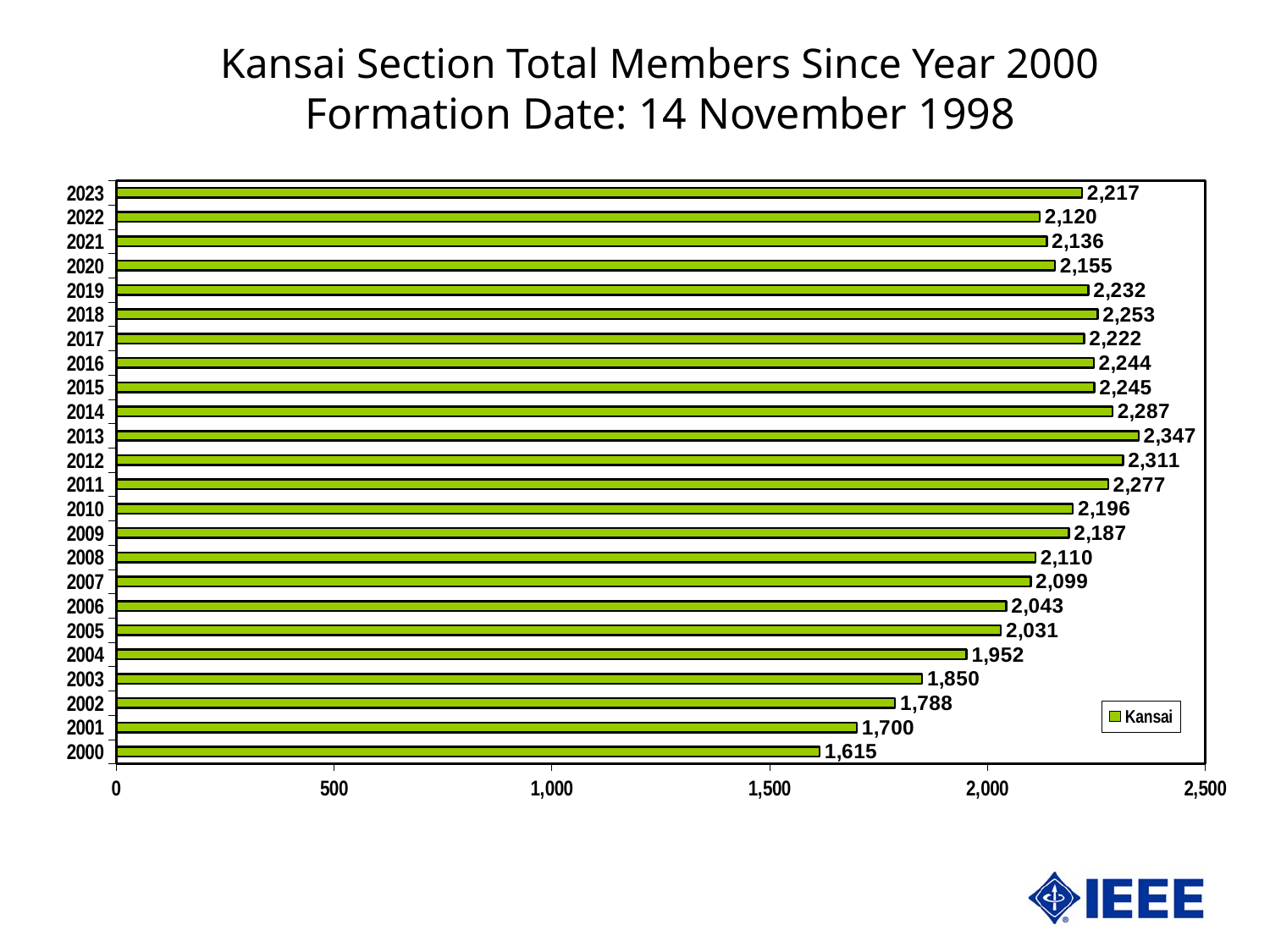
What was the total number of Kansai Section members in 2000? 1,615 What is the difference in members between 2023 and 2022? 97 What is the difference in members between 2013 and 2000? 732 What was the total number of Kansai Section members in 2023? 2,217 Which year had the highest number of members? 2013 What was the total number of Kansai Section members in 2013? 2,347 Which year had the lowest number of members? 2000 What is the only series listed in the legend? Kansai Is the value for 2004 greater or less than 2,000? less What kind of chart is shown on the slide? bar chart Which year had more members, 2012 or 2019? 2012 How many years are shown in the chart? 24